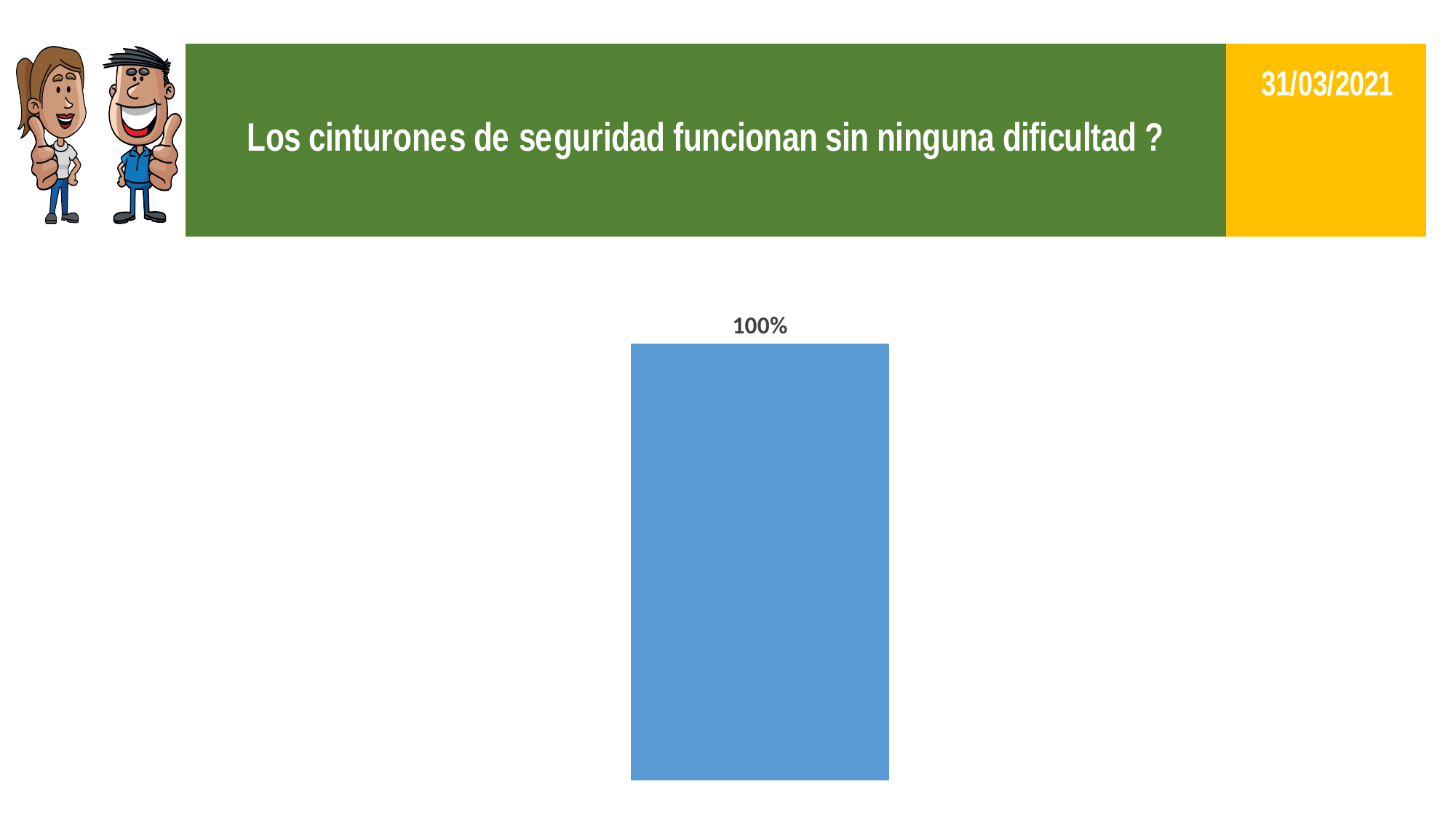
How many bars does the chart show? 1 Is the value shown on the bar greater or less than 50%? greater What kind of chart is shown on the slide? bar chart What colour is the bar in the chart? blue What value is printed as the data label on the bar? 100%